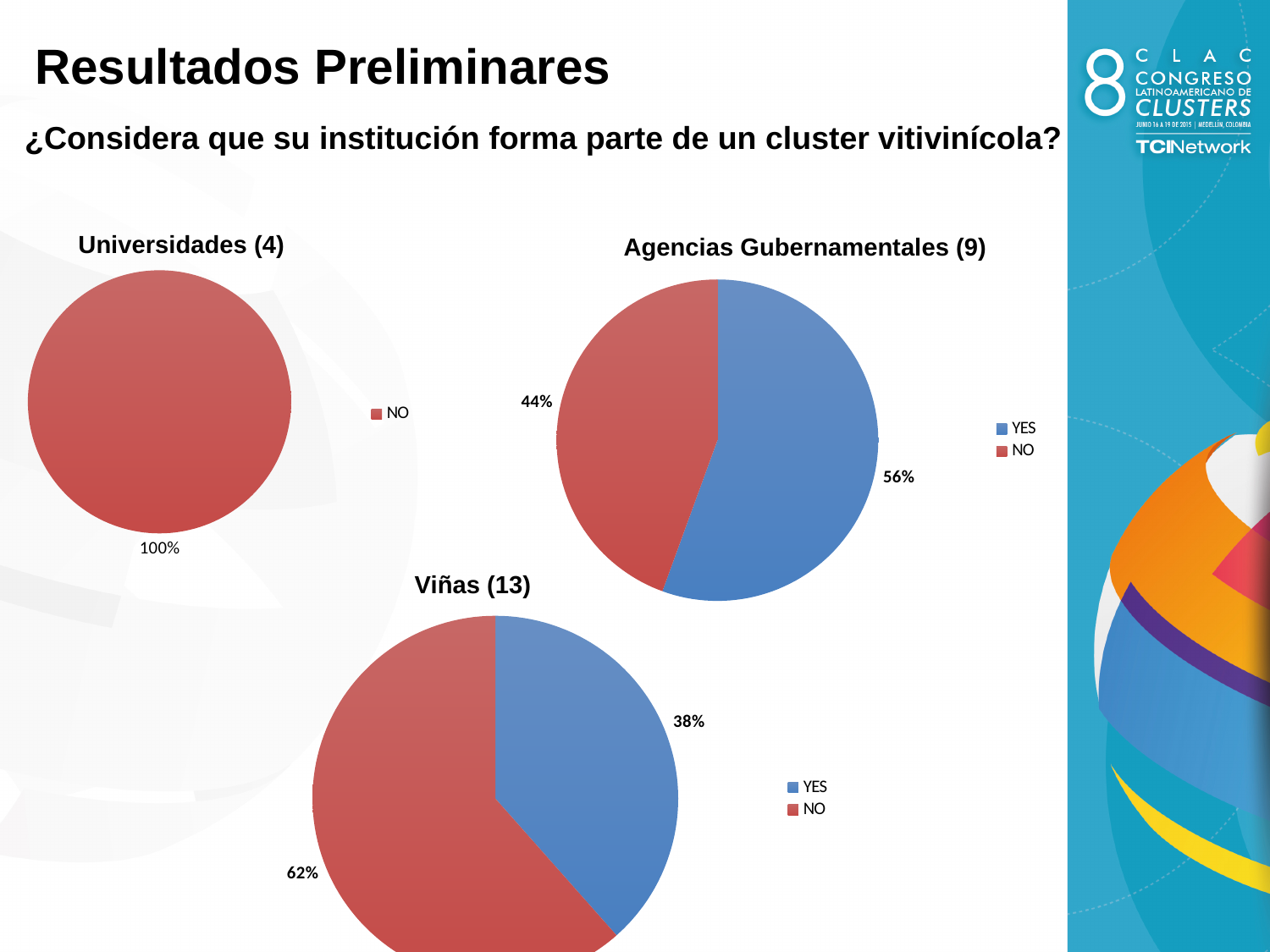
In the 'Viñas (13)' chart, what share is labelled for YES? 38% In the 'Agencias Gubernamentales (9)' chart, what colour is the YES slice? Blue How many entries does the legend of the 'Universidades (4)' chart list? 1 In the 'Agencias Gubernamentales (9)' chart, what share is labelled for NO? 44% In the 'Universidades (4)' chart, what share is labelled for NO? 100% What kind of chart is the 'Viñas (13)' chart? Pie chart In the 'Agencias Gubernamentales (9)' chart, what is the difference in percentage points between the YES and NO slices? 12 In the 'Viñas (13)' chart, which slice is larger, YES or NO? NO In the 'Agencias Gubernamentales (9)' chart, which slice is the largest? YES In the 'Viñas (13)' chart, what is the difference in percentage points between the NO and YES slices? 24